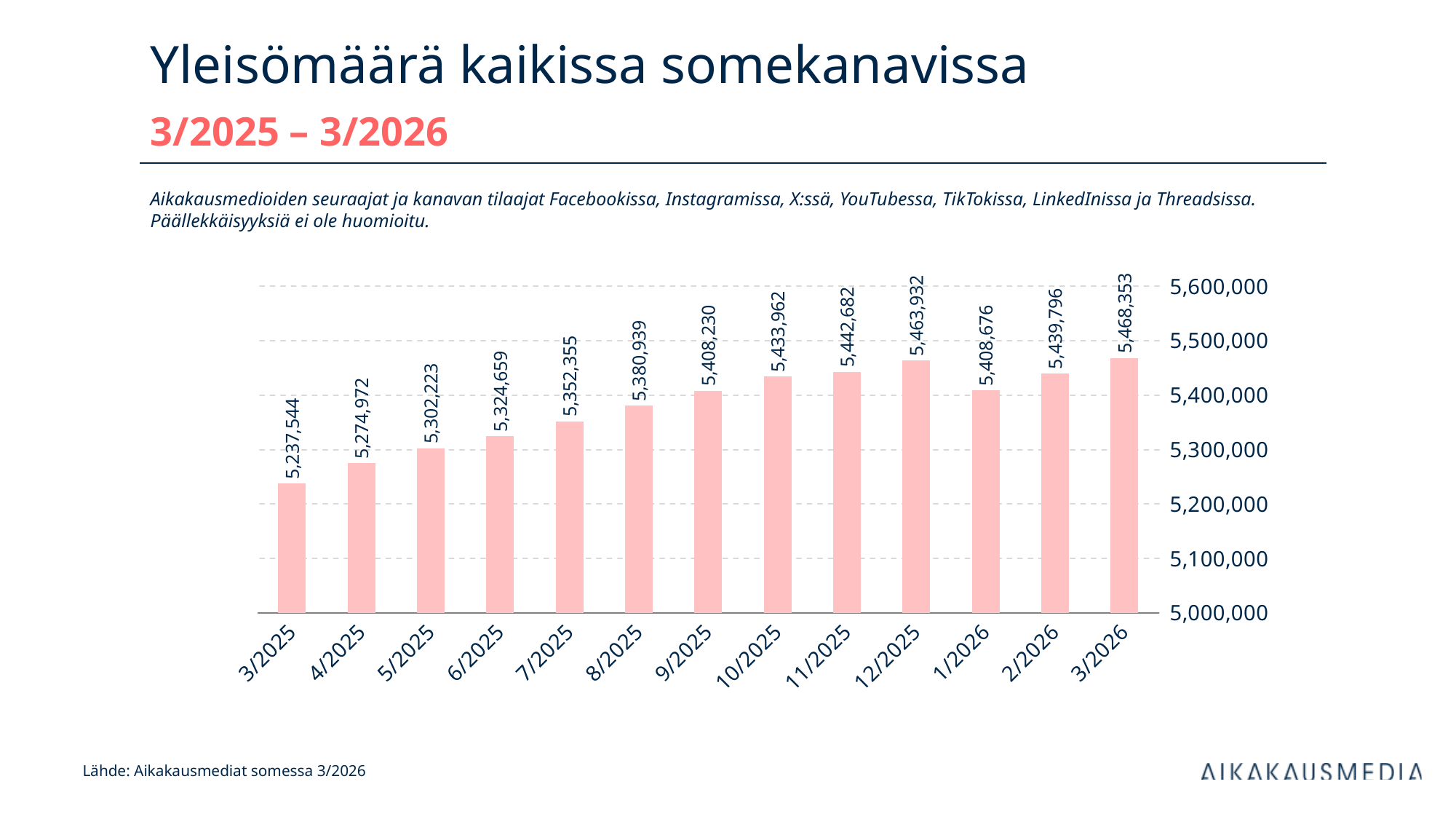
What kind of chart is shown on the slide? bar chart Do the values generally rise or fall from 3/2025 to 3/2026? rise What is the audience value shown for 3/2025? 5,237,544 How many months (bars) are shown in the chart? 13 Which is larger, the value for 10/2025 or the value for 1/2026? 10/2025 Is the value for 6/2025 greater or less than 5,300,000? greater What is the audience value shown for 12/2025? 5,463,932 What is the difference between the values for 3/2026 and 3/2025? 230,809 What is the audience value shown for 1/2026? 5,408,676 What is the difference between the values for 12/2025 and 1/2026? 55,256 Which month has the lowest value in the chart? 3/2025 Which month has the highest value in the chart? 3/2026